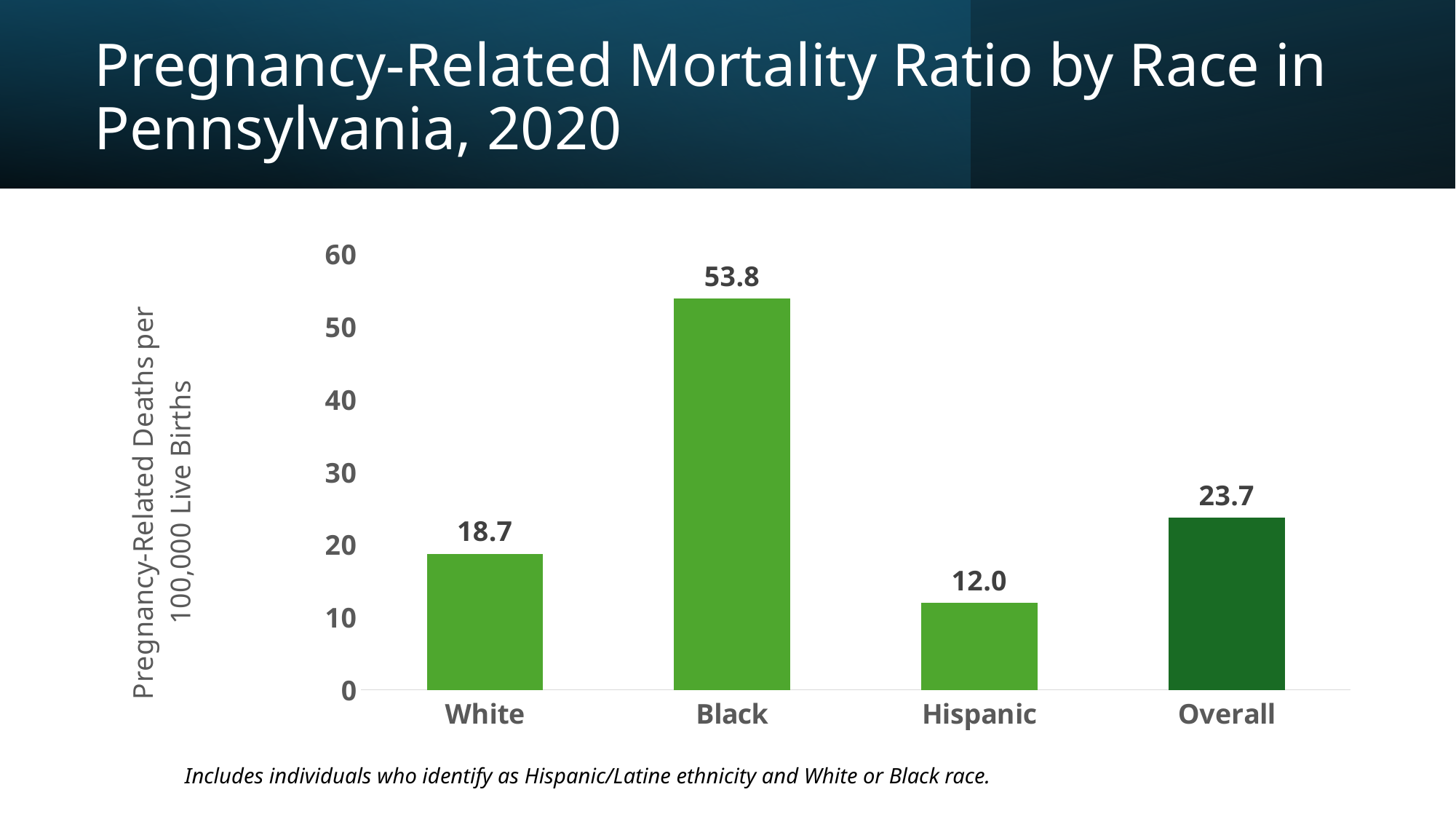
Which category has the lowest pregnancy-related mortality ratio? Hispanic What is the pregnancy-related mortality ratio for Hispanic individuals? 12.0 What is the pregnancy-related mortality ratio for Black individuals? 53.8 What is the pregnancy-related mortality ratio for White individuals? 18.7 What is the Overall pregnancy-related mortality ratio shown? 23.7 What kind of chart is shown on the slide? Bar chart How many categories are shown on the x axis? 4 Is the value for Black greater or less than 50? greater Which category has the highest pregnancy-related mortality ratio? Black Which is larger, the mortality ratio for White individuals or the Overall ratio? Overall What is the label of the vertical axis? Pregnancy-Related Deaths per 100,000 Live Births What is the difference between the mortality ratio for Black and White individuals? 35.1